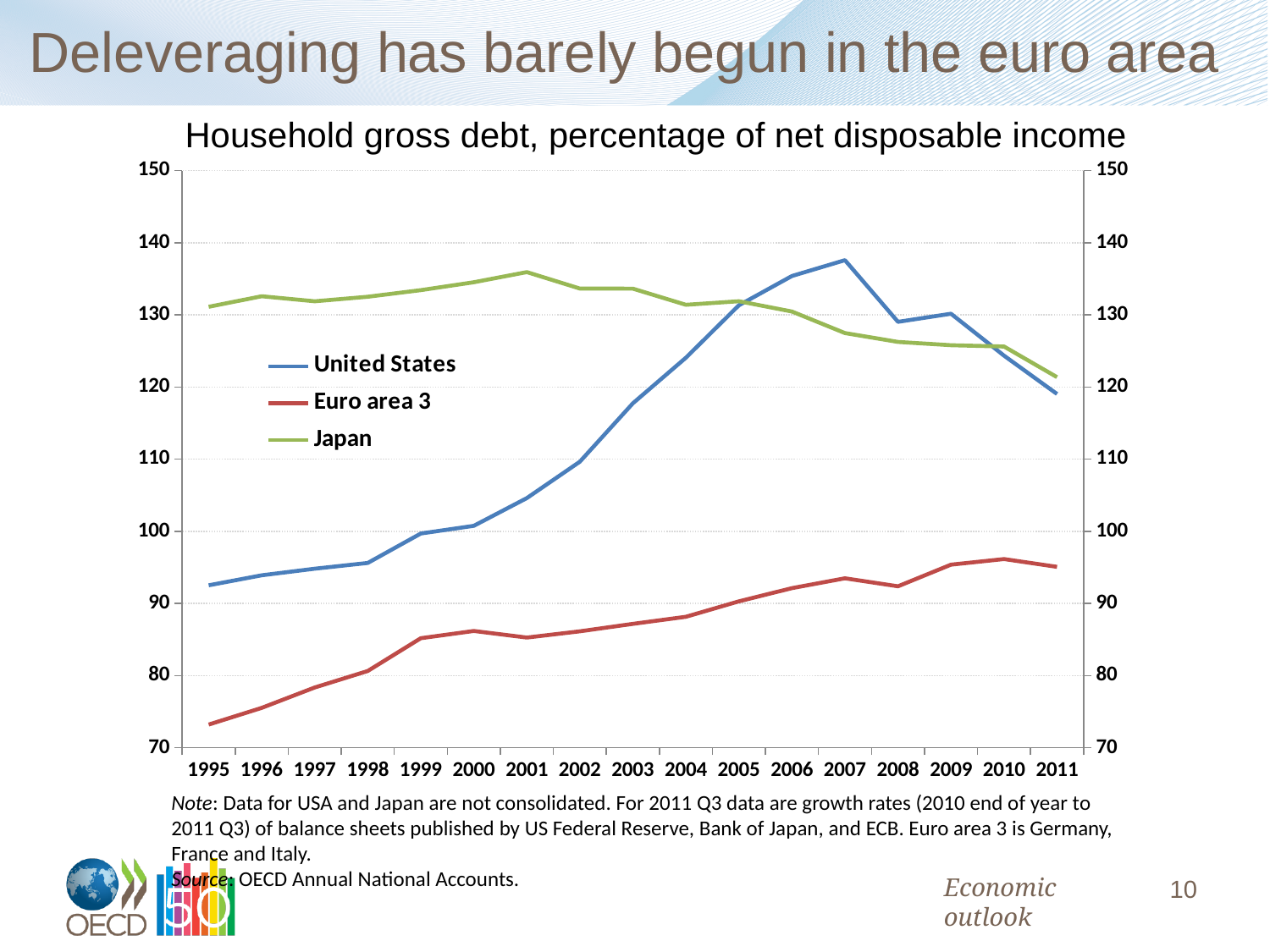
How many series does the legend list? 3 Is the value for Euro area 3 in 1995 greater or less than 80? less Is the value for Japan in 2001 greater or less than 130? greater What kind of chart is shown on the slide? line chart Which series has the lowest value in 2011? Euro area 3 In which year does the United States series reach its highest value? 2007 Which series is drawn in green? Japan In 2000, which is higher, Japan or United States? Japan How many years are shown along the x axis? 17 Is the value for United States in 2007 greater or less than 130? greater What is the title of the chart? Household gross debt, percentage of net disposable income Does the United States series rise or fall between 2007 and 2011? fall